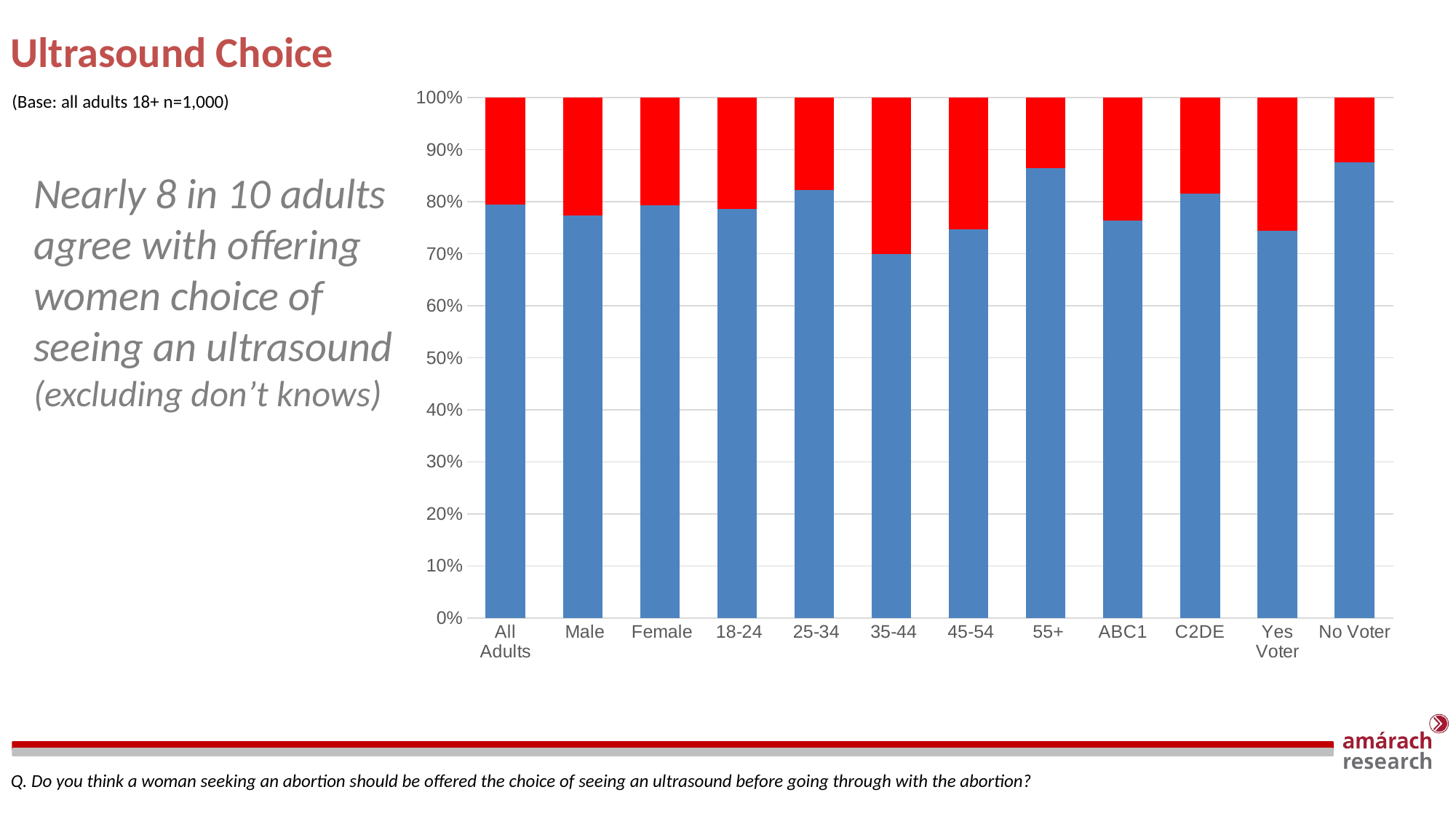
Which has the larger blue segment, 55+ or 35-44? 55+ Is the blue segment for 55+ greater or less than 80%? greater What is the title of the slide containing the chart? Ultrasound Choice What does each stacked bar in the chart total? 100% Is the blue segment for No Voter greater or less than 80%? greater What kind of chart is shown on the slide? Stacked bar chart Is the blue segment for 25-34 greater or less than 80%? greater How many categories are shown along the x axis of the chart? 12 Which has the larger blue segment, 25-34 or 45-54? 25-34 Which category has the smallest blue segment in the chart? 35-44